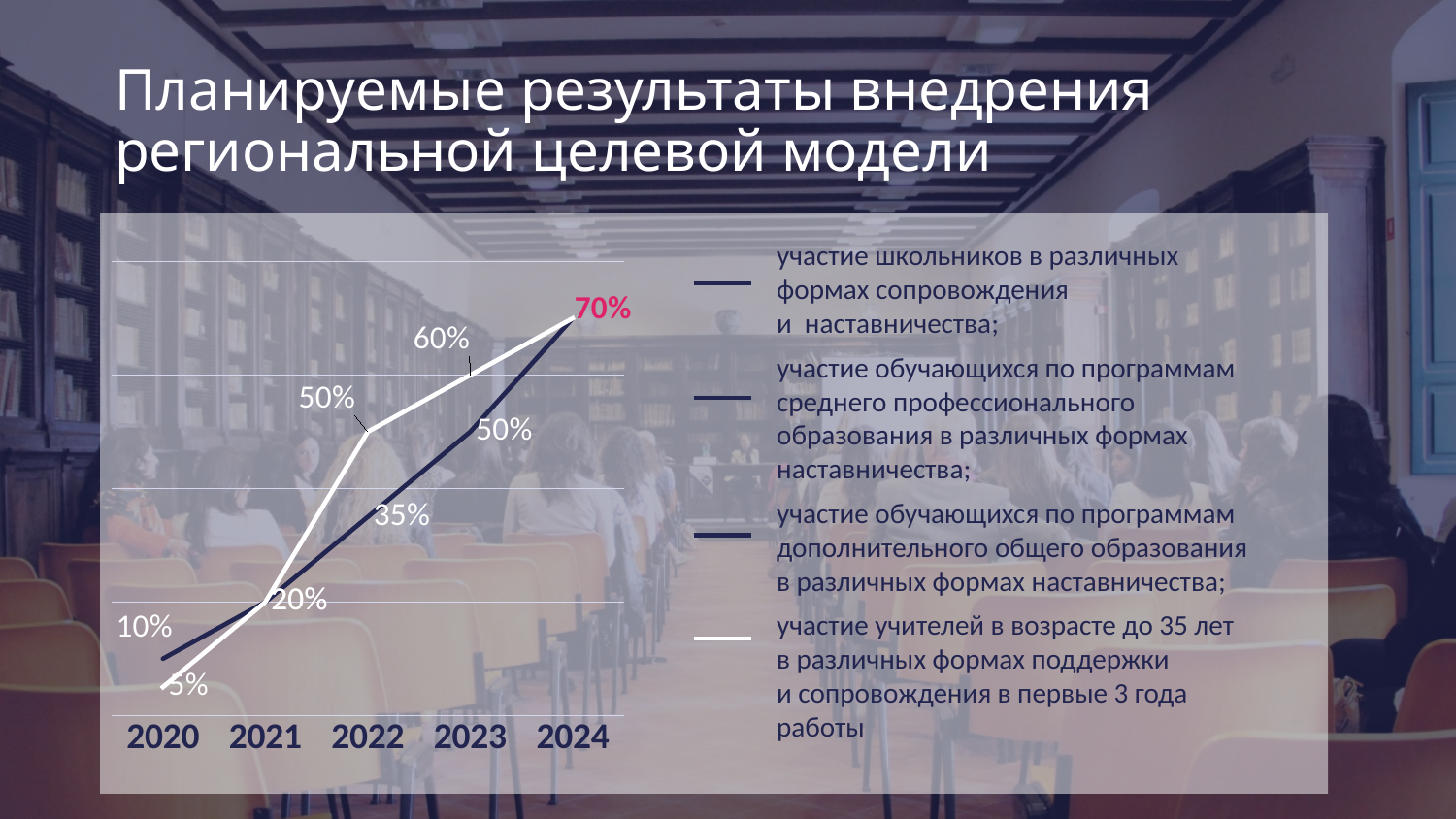
What value do the lines reach in 2024? 70% In which year does the white line reach its highest value? 2024 What is the value of the dark line in 2020? 10% How many years are shown on the x axis of the chart? 5 By how much does the white line increase from 2020 (5%) to 2024 (70%)? 65% What is the value of the white line (участие учителей в возрасте до 35 лет) in 2023? 60% What kind of chart is shown on the slide? line chart Do the values rise or fall from 2020 to 2024? rise In 2022, which line has the larger value, the white line or the dark line? the white line What is the value of the dark line in 2022? 35% What is the value of the white line (участие учителей в возрасте до 35 лет) in 2020? 5%